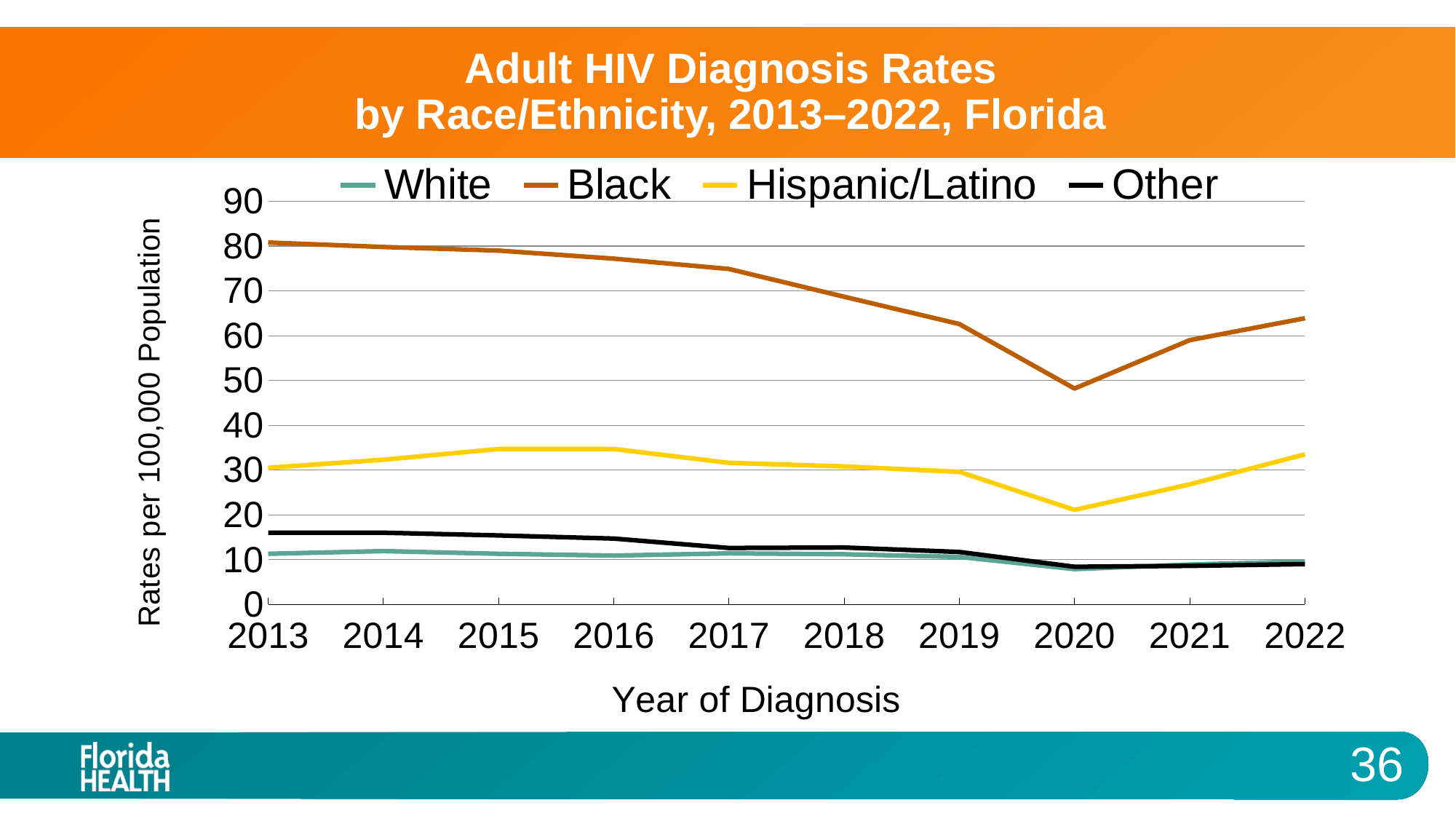
Is the value for Black in 2020 greater or less than 60? less How many years are shown along the x axis? 10 Is the value for Hispanic/Latino in 2020 greater or less than 30? less Is the value for Black in 2013 greater or less than 70? greater What is the title of the y axis? Rates per 100,000 Population In which year does the Black series reach its lowest value? 2020 Which race/ethnicity group has the highest diagnosis rate in 2013? Black What kind of chart is shown on the slide? line chart How many series does the legend list? 4 Does the Black series rise or fall from 2013 to 2020? fall Which is larger in 2016, the value for Hispanic/Latino or the value for Other? Hispanic/Latino Which race/ethnicity group has the lowest diagnosis rate in 2013? White